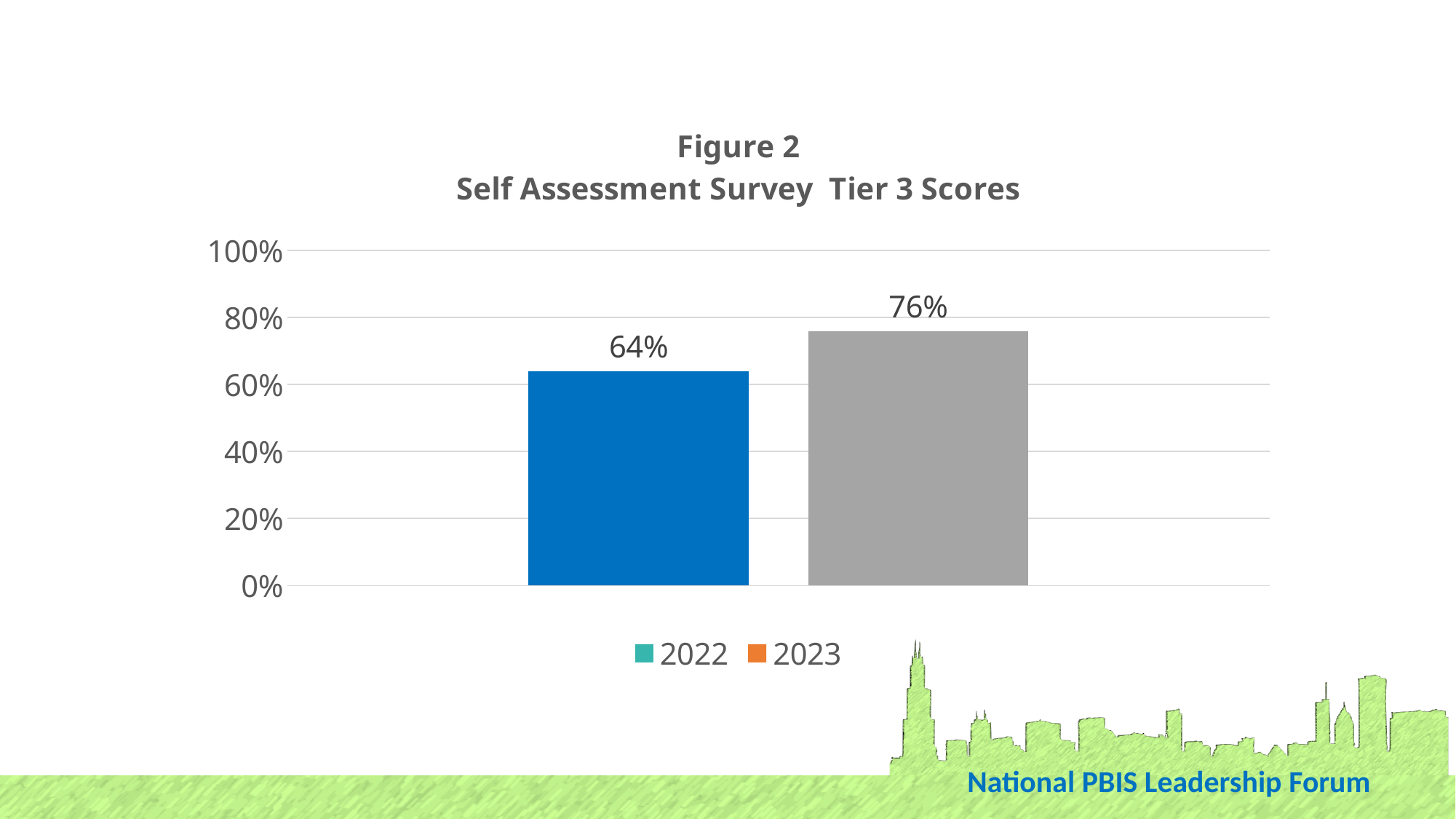
Is the 2023 score larger or smaller than the 2022 score? larger What is the title of the chart? Figure 2 Self Assessment Survey Tier 3 Scores Which year has the lower Self Assessment Survey Tier 3 score? 2022 What is the Tier 3 score for 2023? 76% What is the Tier 3 score for 2022? 64% Which year has the higher Self Assessment Survey Tier 3 score? 2023 How many series does the legend list? 2 How many bars are plotted in the chart? 2 What kind of chart is shown on the slide? bar chart Is the value for 2022 greater or less than 60%? greater By how many percentage points did the Tier 3 score change from 2022 to 2023? 12 percentage points Is the value for 2023 greater or less than 80%? less